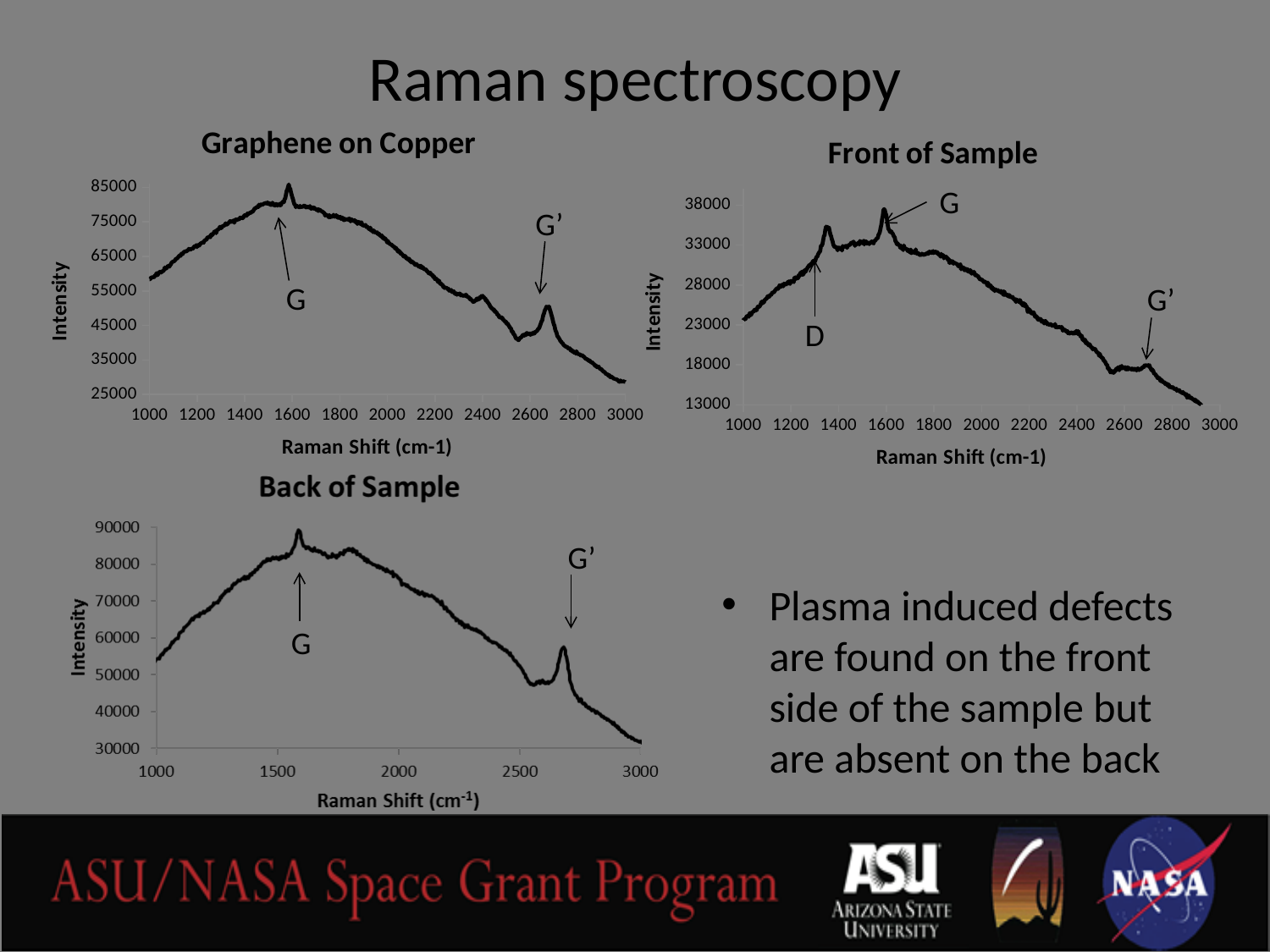
In the 'Front of Sample' chart, is the intensity at a Raman shift of 1000 greater or less than 28000? less In the 'Graphene on Copper' chart, which peak has the higher intensity, G or G'? G In the 'Graphene on Copper' chart, is the intensity at the G peak near 1600 cm-1 greater or less than 75000? greater What is the x-axis label of the 'Front of Sample' chart? Raman Shift (cm-1) In the 'Back of Sample' chart, is the intensity at the G' peak near 2700 cm-1 greater or less than 50000? greater In the 'Back of Sample' chart, does the intensity rise or fall between Raman shifts of 1000 and 1500? rise What kind of chart is the 'Graphene on Copper' chart? line chart In the 'Front of Sample' chart, does the intensity rise or fall between Raman shifts of 2000 and 2600? fall Which chart on the slide has a peak labelled D? Front of Sample